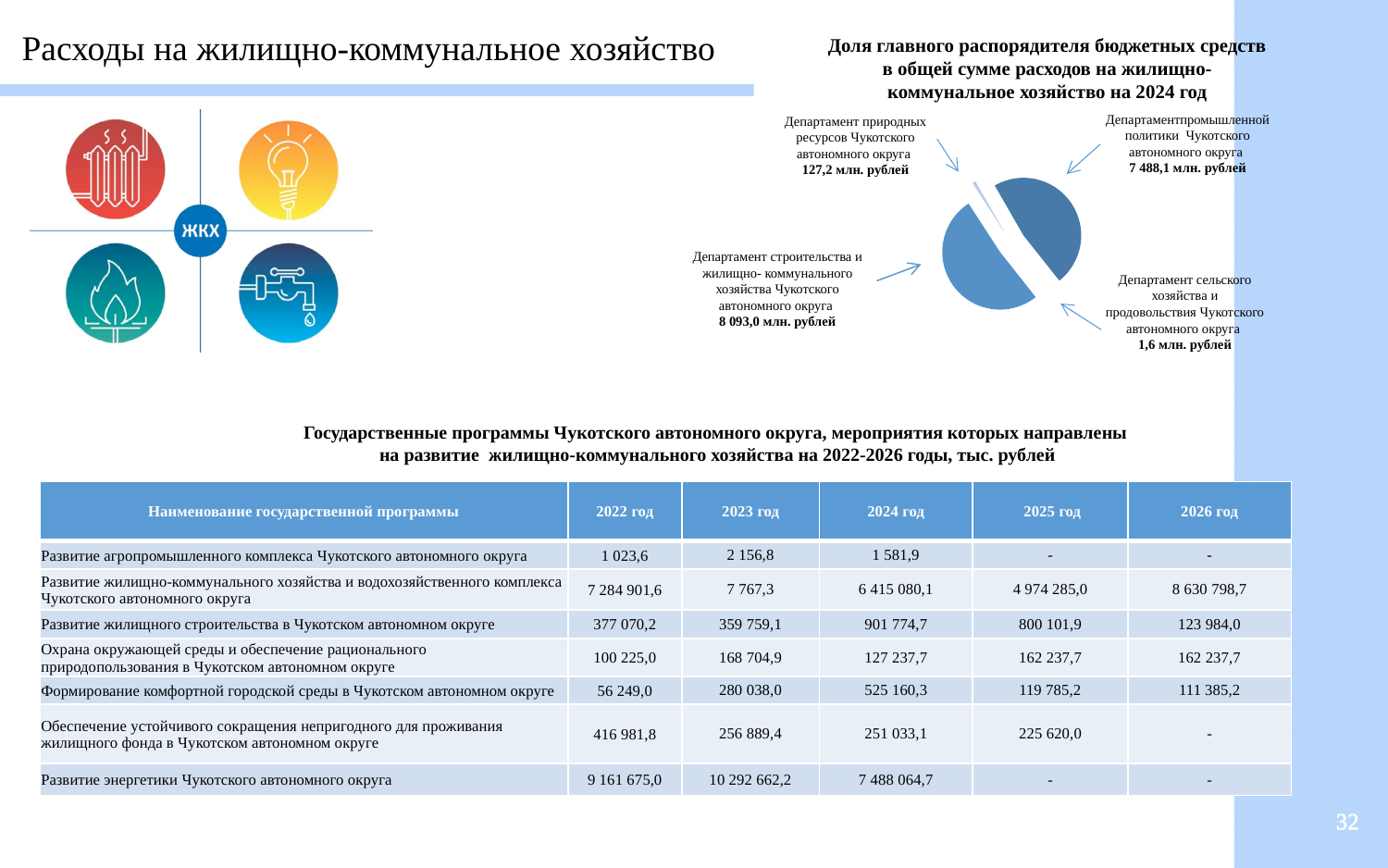
Что больше на круговой диаграмме: значение Департамента природных ресурсов или Департамента сельского хозяйства и продовольствия? Департамент природных ресурсов На сколько млн. рублей значение Департамента строительства и жилищно-коммунального хозяйства больше значения Департамента промышленной политики на круговой диаграмме? 604,9 млн. рублей Какое значение на круговой диаграмме указано для Департамента сельского хозяйства и продовольствия Чукотского автономного округа? 1,6 млн. рублей Какой распорядитель бюджетных средств имеет наибольшую долю на круговой диаграмме? Департамент строительства и жилищно-коммунального хозяйства Чукотского автономного округа Какое значение на круговой диаграмме указано для Департамента промышленной политики Чукотского автономного округа? 7 488,1 млн. рублей Какое значение на круговой диаграмме указано для Департамента строительства и жилищно-коммунального хозяйства Чукотского автономного округа? 8 093,0 млн. рублей Какое значение на круговой диаграмме указано для Департамента природных ресурсов Чукотского автономного округа? 127,2 млн. рублей Какой распорядитель бюджетных средств имеет наименьшую долю на круговой диаграмме? Департамент сельского хозяйства и продовольствия Чукотского автономного округа Сколько категорий (распорядителей бюджетных средств) показано на круговой диаграмме? 4 Как называется круговая диаграмма на слайде? Доля главного распорядителя бюджетных средств в общей сумме расходов на жилищно-коммунальное хозяйство на 2024 год На сколько млн. рублей значение Департамента природных ресурсов больше значения Департамента сельского хозяйства и продовольствия на круговой диаграмме? 125,6 млн. рублей Какой тип диаграммы используется на слайде для отображения доли главного распорядителя бюджетных средств? Круговая диаграмма